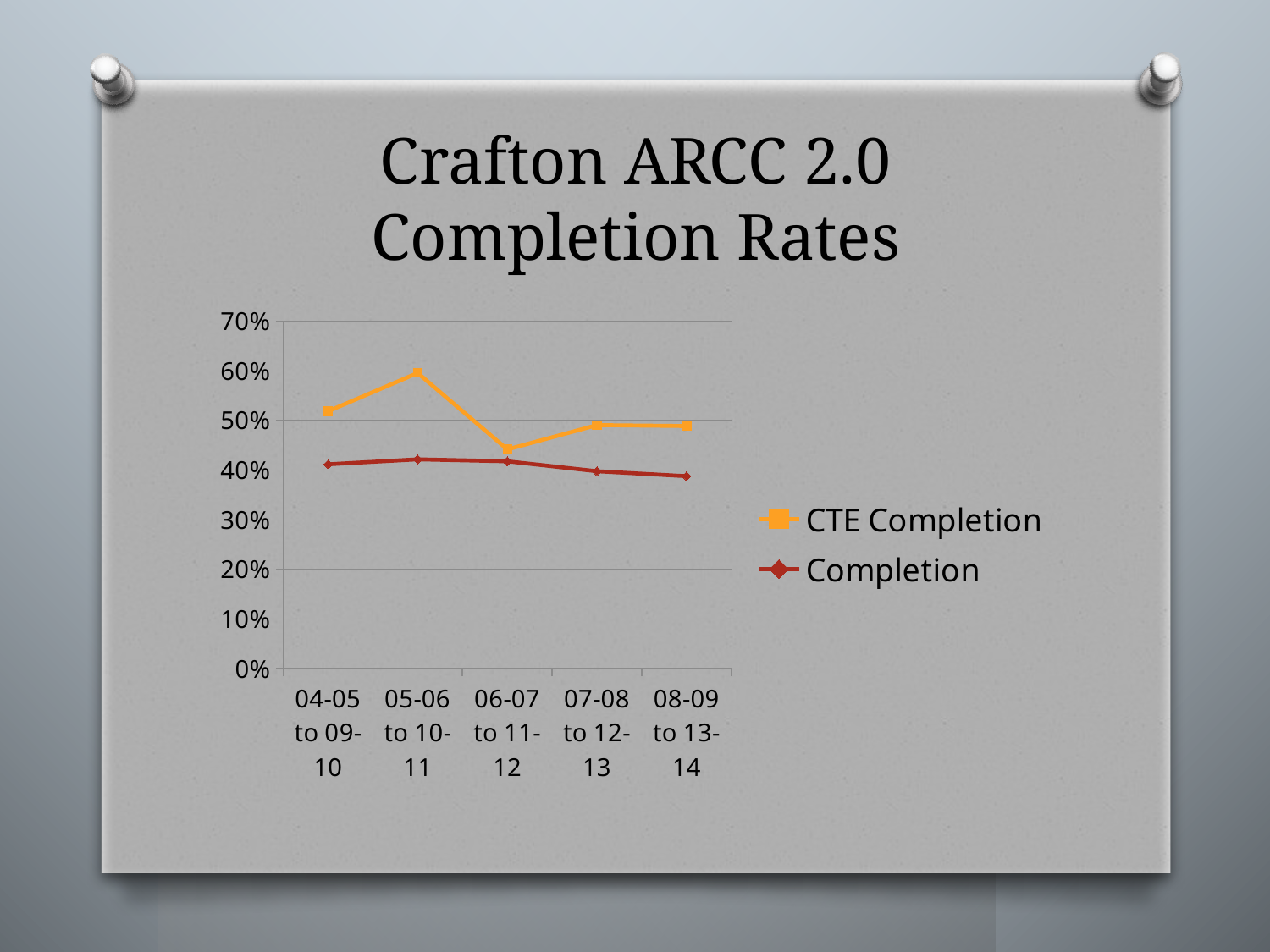
Is the Completion value for 05-06 to 10-11 greater or less than 50%? less Is the CTE Completion value for 06-07 to 11-12 greater or less than 50%? less What is the title of the chart slide? Crafton ARCC 2.0 Completion Rates For 05-06 to 10-11, which series has the larger value, CTE Completion or Completion? CTE Completion Is the Completion value for 08-09 to 13-14 greater or less than 30%? greater What kind of chart is shown on the slide? Line chart Does the Completion line end higher or lower in 08-09 to 13-14 than it starts in 04-05 to 09-10? Lower In which period is the CTE Completion rate highest? 05-06 to 10-11 In which period is the CTE Completion rate lowest? 06-07 to 11-12 How many series does the legend list? 2 How many time periods are plotted along the x axis? 5